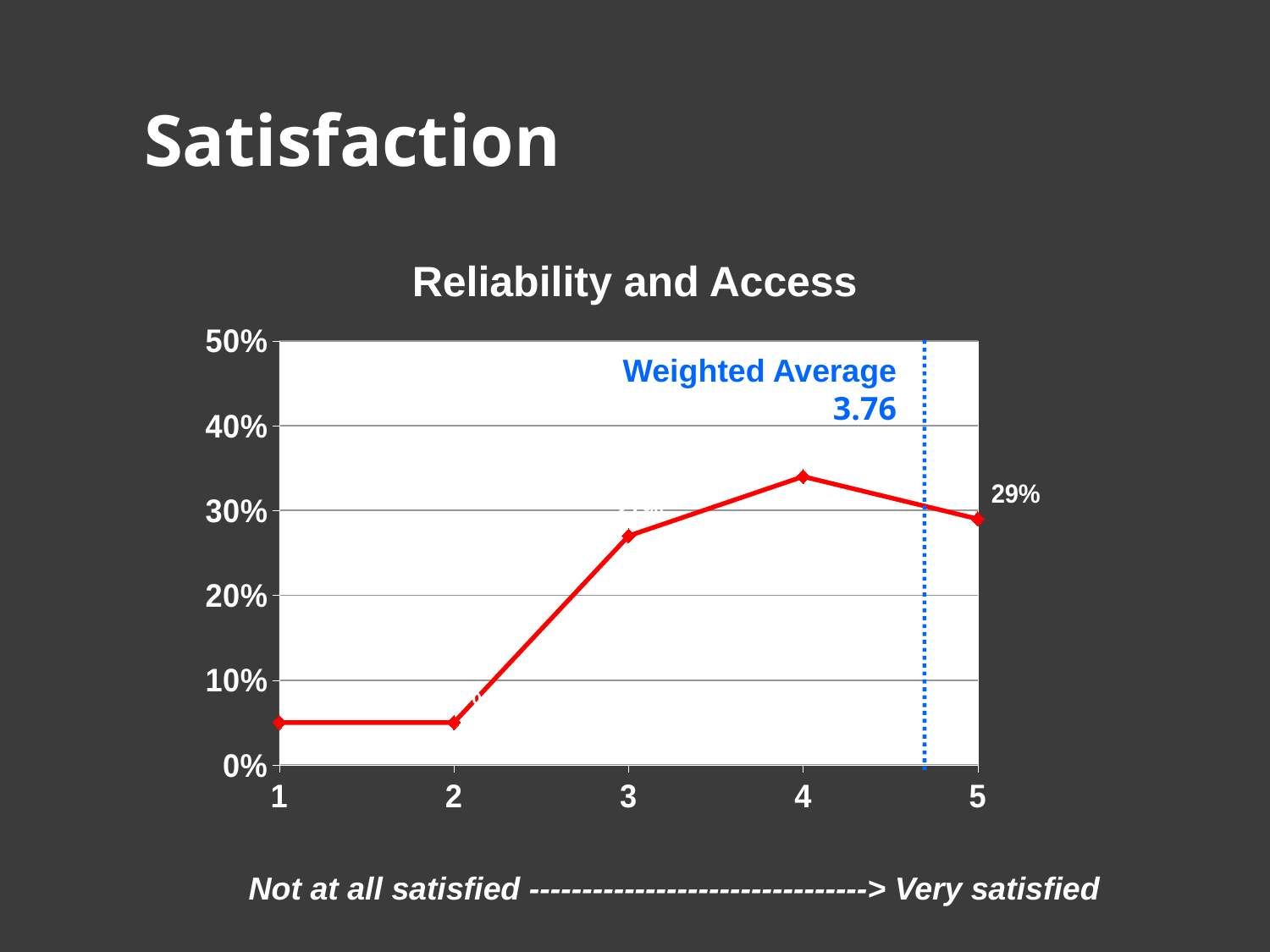
Is the value for category 1 greater or less than 10%? less Which category has the highest value? 4 Which has the larger value, category 4 or category 5? 4 Is the value for category 2 greater or less than 10%? less Do the values rise or fall from category 2 to category 4? rise Is the value for category 4 greater or less than 30%? greater What is the title of the chart? Reliability and Access What kind of chart is shown on the slide? line chart What is the value plotted for category 5? 29% How many points are plotted on the line? 5 What weighted average is annotated on the chart? 3.76